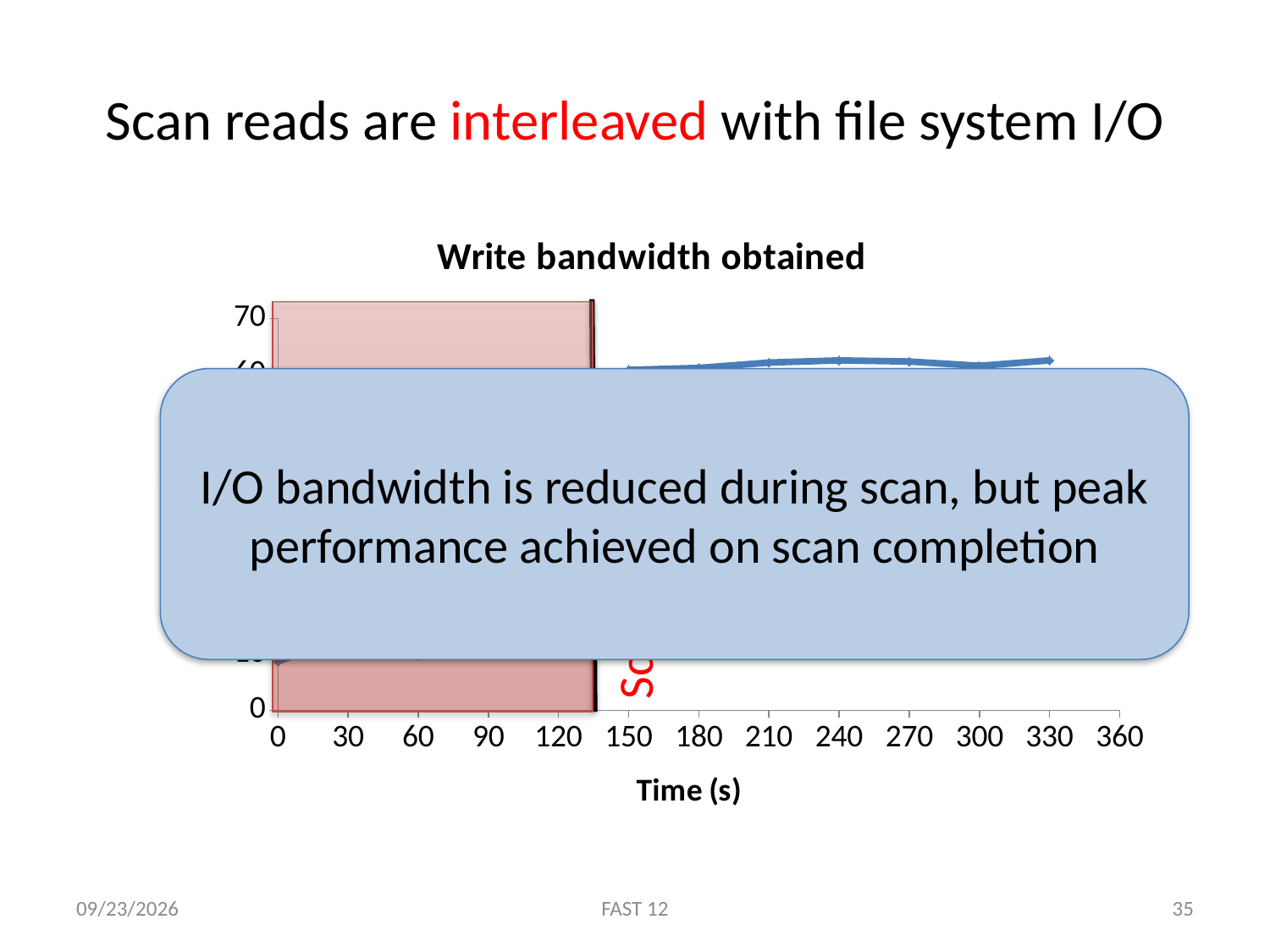
What is the label of the x axis? Time (s) What is the title of the chart? Write bandwidth obtained Is the value at 300 s greater or less than 70? less Is the value at 240 s greater or less than 70? less What kind of chart is shown on the slide? line chart Is the value at 210 s greater or less than 0? greater